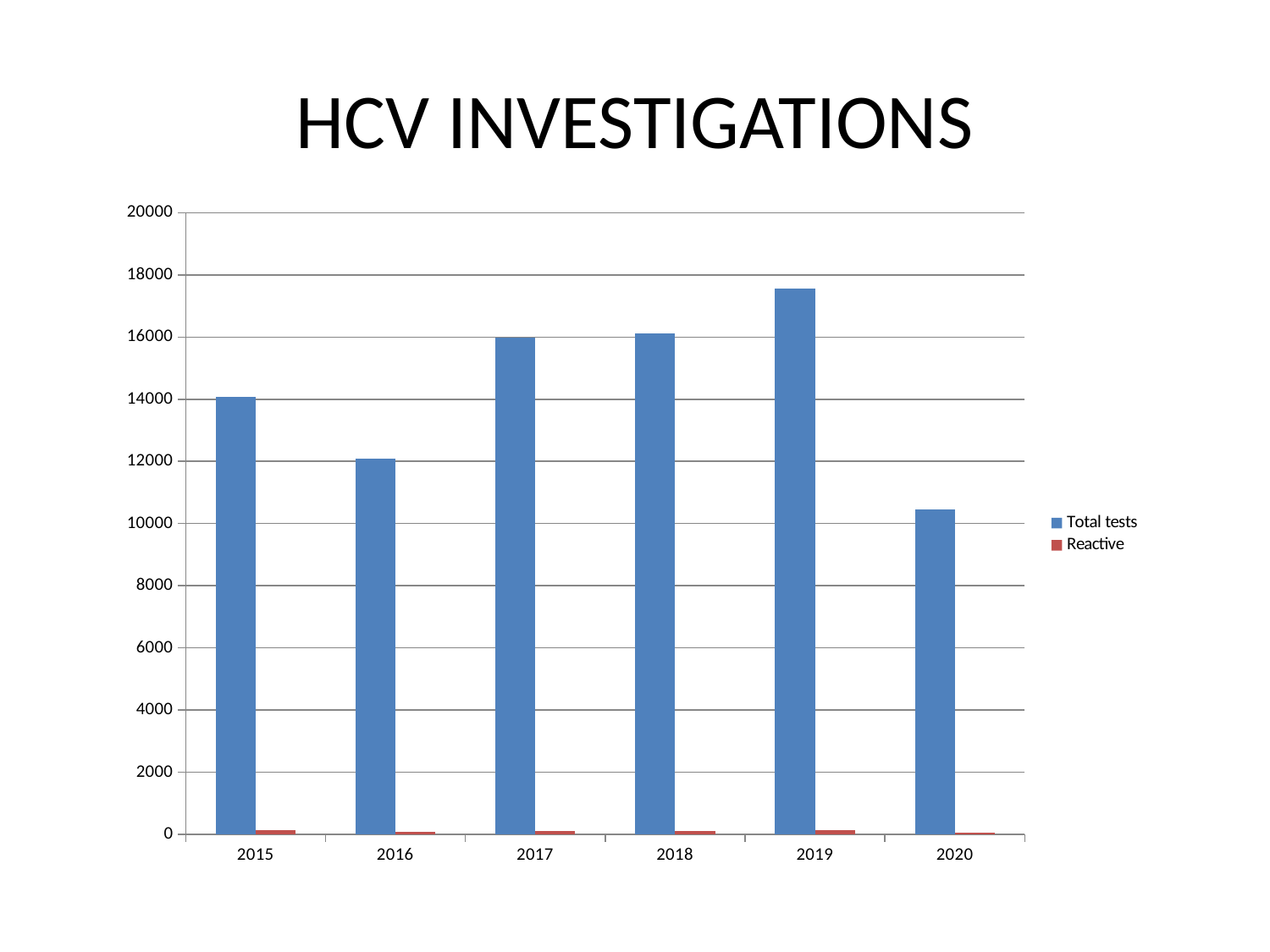
What type of chart is shown on the slide? bar chart Which is larger, Total tests in 2015 or Total tests in 2017? 2017 How many series does the legend list? 2 Is the value for Total tests in 2019 greater or less than 16000? greater How many years are shown on the x axis? 6 Which year has the highest value for Total tests? 2019 Is the value for Total tests in 2020 greater or less than 12000? less Which is larger, Total tests in 2016 or Total tests in 2020? 2016 Which series is shown in red? Reactive Is the value for Total tests in 2016 greater or less than 14000? less What is the title of the chart? HCV INVESTIGATIONS Which year has the lowest value for Total tests? 2020